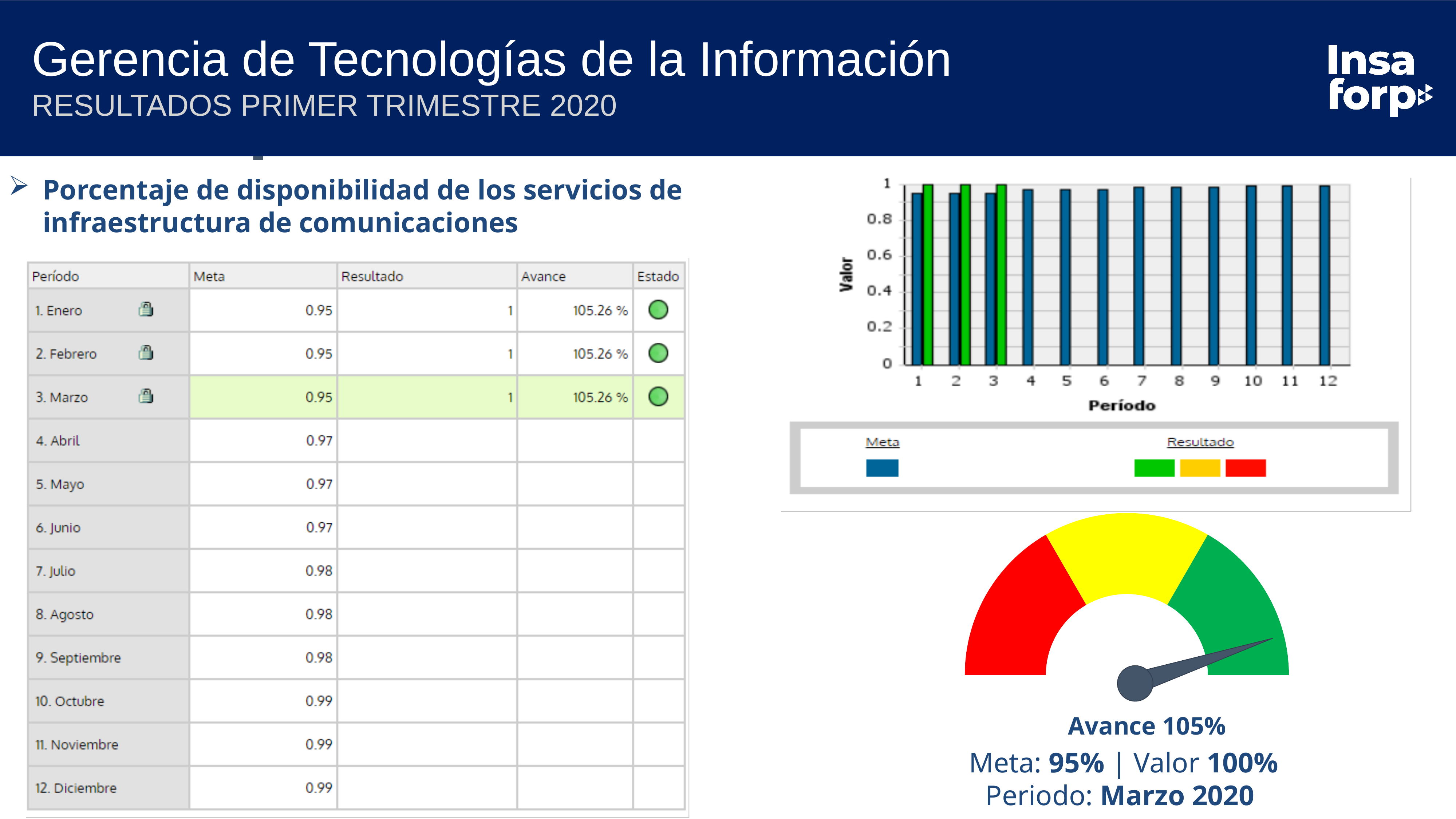
In the bar chart at the top right, what are the two series named in the legend? Meta and Resultado In the bar chart at the top right, do the Meta bars rise or fall from period 1 to period 12? rise In the bar chart at the top right, how many periods are shown on the x axis? 12 What kind of chart is the chart at the top right of the slide with the x axis labelled Período? bar chart In the bar chart at the top right, what colour are the Meta bars? blue In the bar chart at the top right, which is larger for period 2, the Meta bar or the Resultado bar? Resultado In the bar chart at the top right, for how many periods is a Resultado bar plotted? 3 In the bar chart at the top right, is the Meta value for period 12 greater or less than 0.8? greater In the bar chart at the top right, how many series does the legend list? 2 In the bar chart at the top right, what is the Resultado value for period 1? 1 In the bar chart at the top right, is the Meta value for period 1 greater or less than 0.6? greater What Avance value is shown below the gauge chart at the bottom right? 105%